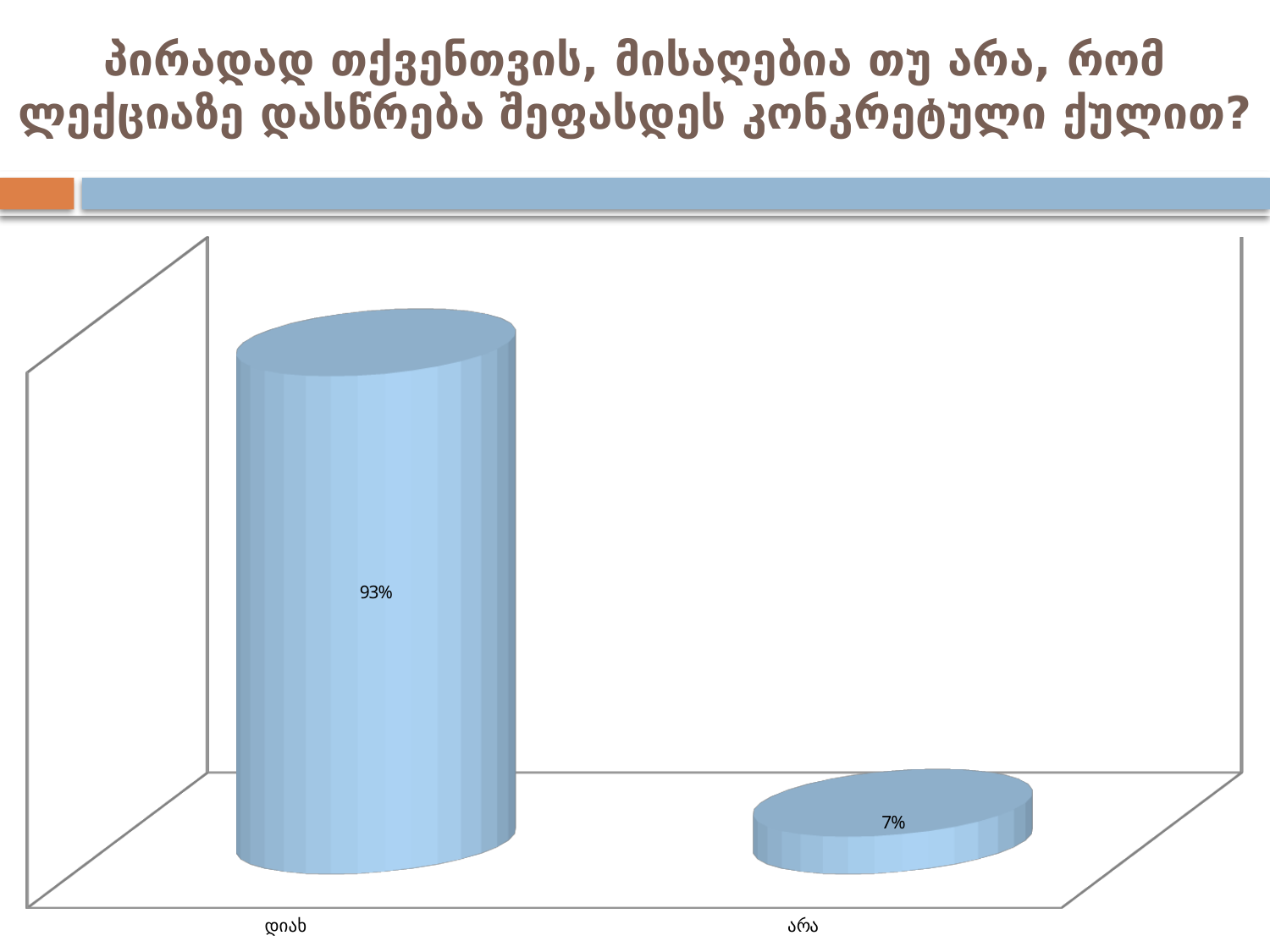
What kind of chart is shown on the slide? Bar chart Which category has the highest value? დიახ What is the label of the category on the left of the chart? დიახ Which category has the lowest value? არა What is the difference between the values for დიახ and არა? 86% What colour are the bars in the chart? Light blue Which is larger, the value for დიახ or the value for არა? დიახ How many categories are shown in the chart? 2 What is the total of the two values shown in the chart? 100% What is the value for არა? 7% What is the value for დიახ? 93%